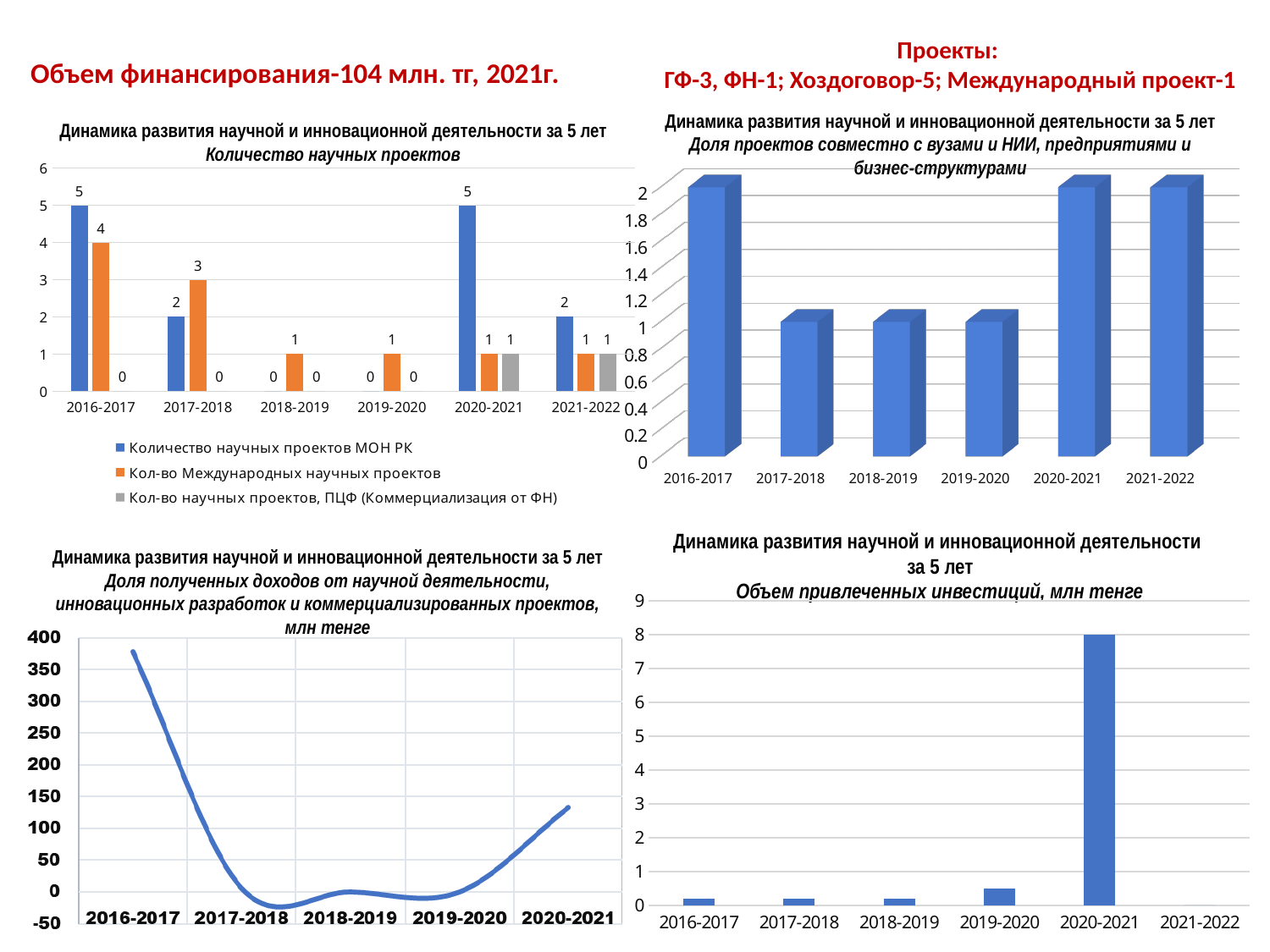
In the 'Количество научных проектов' chart, how many series does the legend list? 3 In the 'Количество научных проектов' chart, which is larger in 2021-2022: 'Количество научных проектов МОН РК' or 'Кол-во Международных научных проектов'? Количество научных проектов МОН РК In the 'Количество научных проектов' chart, how many categories are shown on the x axis? 6 What kind of chart is the 'Доля полученных доходов от научной деятельности, инновационных разработок и коммерциализированных проектов, млн тенге' chart? line chart In the 'Доля проектов совместно с вузами и НИИ, предприятиями и бизнес-структурами' chart, is the value for 2017-2018 greater or less than 1.5? less In the 'Количество научных проектов' chart, what is the value for 'Количество научных проектов МОН РК' in 2016-2017? 5 In the 'Количество научных проектов' chart, what is the difference between 'Количество научных проектов МОН РК' and 'Кол-во Международных научных проектов' in 2020-2021? 4 In the 'Объем привлеченных инвестиций, млн тенге' chart, which category has the highest value? 2020-2021 In the 'Количество научных проектов' chart, what is the value for 'Кол-во Международных научных проектов' in 2017-2018? 3 In the 'Доля проектов совместно с вузами и НИИ, предприятиями и бизнес-структурами' chart, which is larger: 2016-2017 or 2018-2019? 2016-2017 In the 'Доля полученных доходов от научной деятельности' line chart, is the value for 2016-2017 greater or less than 300? greater In the 'Объем привлеченных инвестиций, млн тенге' chart, is the value for 2019-2020 greater or less than 1? less